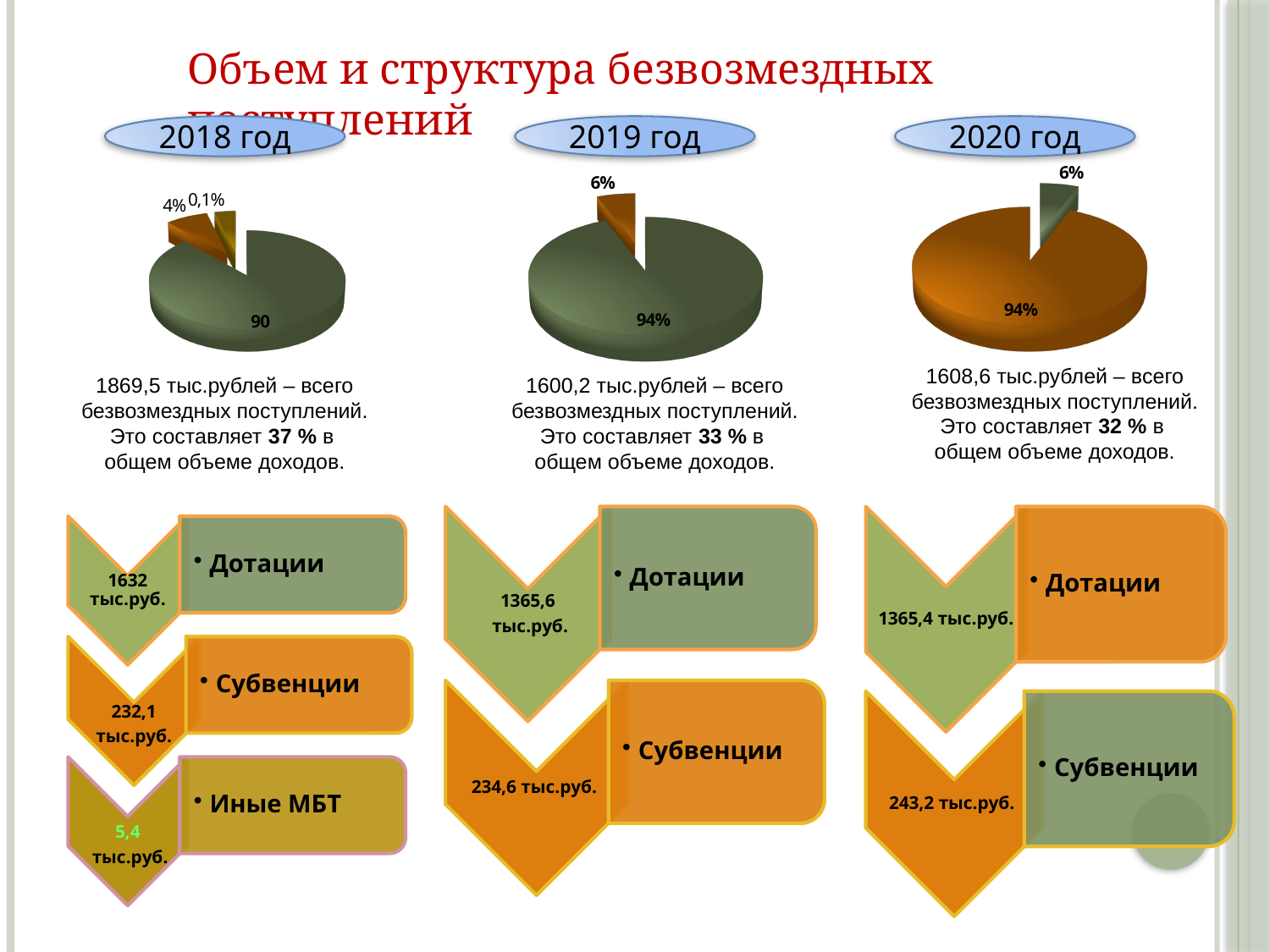
In the 2020 год pie chart, what colour is the largest slice? Orange/brown In the 2018 год pie chart, what is the smallest percentage label shown? 0,1% In the 2018 год pie chart, what value is printed on the largest slice? 90 In the 2020 год pie chart, what is the difference in percentage points between the large slice and the small slice? 88 In the 2020 год pie chart, what percentage is printed on the largest slice? 94% What type of chart is used for each of the three years on the slide? Pie chart How many pie charts are shown on the slide? 3 In the 2018 год pie chart, how many slices are there? 3 In the 2018 год pie chart, which labelled slice is larger: the one labelled 4% or the one labelled 0,1%? 4% In the 2019 год pie chart, what percentage is printed on the small slice? 6% In the 2019 год pie chart, how many slices are there? 2 In the 2019 год pie chart, what percentage is printed on the largest slice? 94%